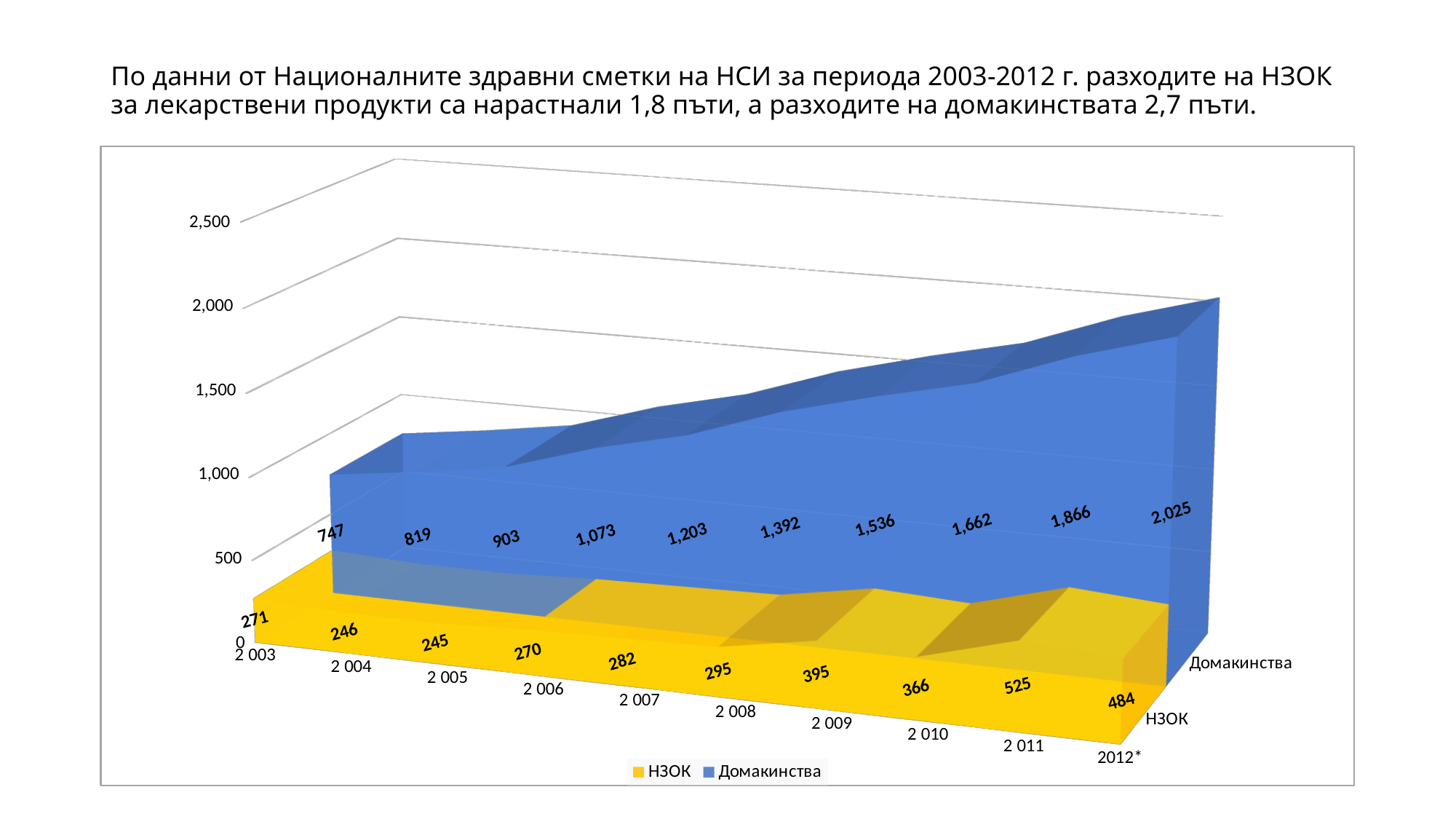
What is the value for НЗОК in 2 011? 525 Do the Домакинства values rise or fall from 2 003 to 2012*? Rise What kind of chart is shown on the slide? Area chart What is the difference between the Домакинства value and the НЗОК value in 2012*? 1,541 What is the value for Домакинства in 2012*? 2,025 In which year is the Домакинства value highest? 2012* What is the value for Домакинства in 2 008? 1,392 What is the value for НЗОК in 2 003? 271 Which is larger in 2 010: the НЗОК value or the Домакинства value? Домакинства How many series does the legend list? 2 How many years are shown on the x axis? 10 In which year is the НЗОК value lowest? 2 005